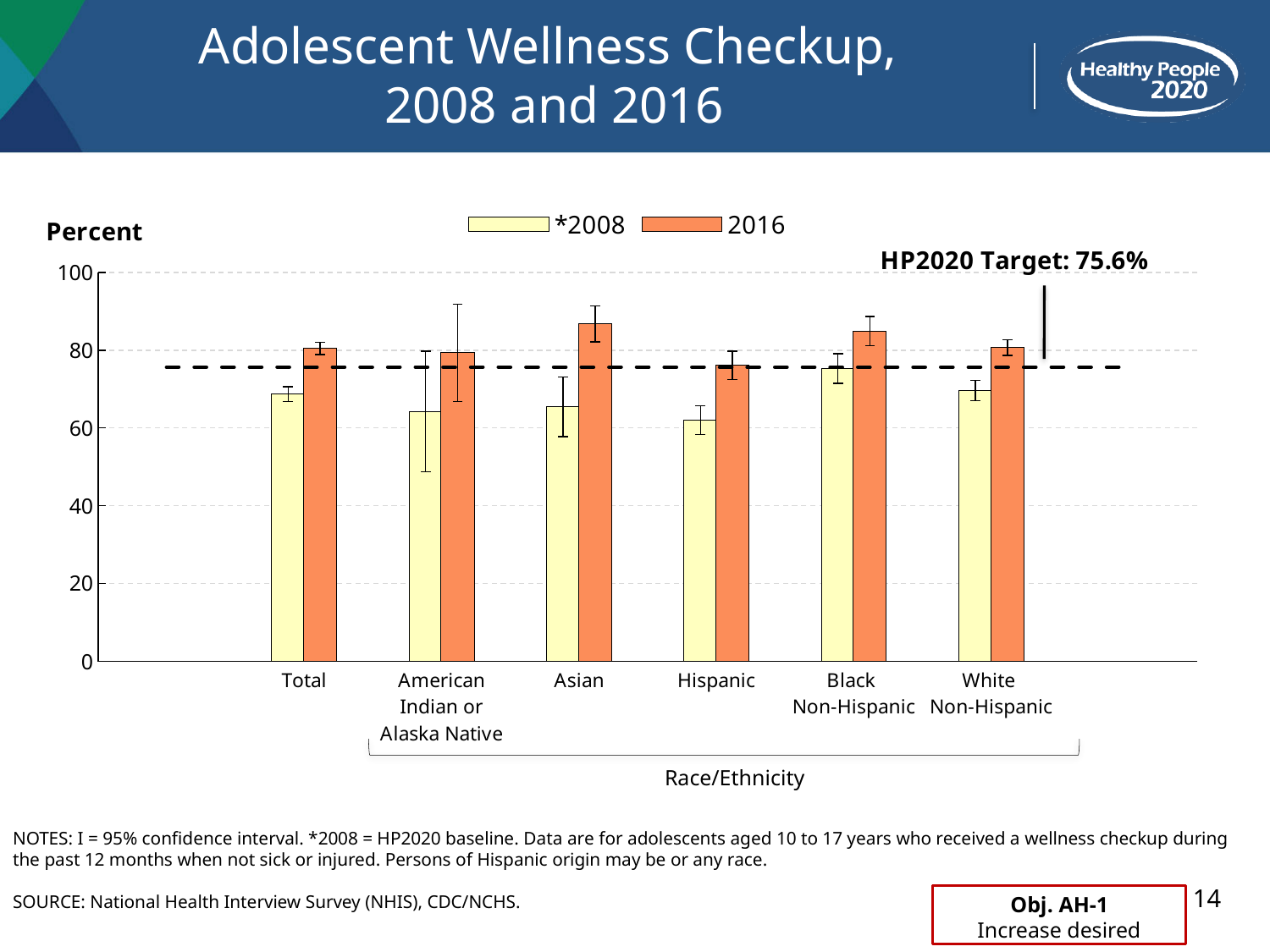
Is the 2008 value for Total greater or less than 60? greater For the 2008 series, which is larger: Black Non-Hispanic or Hispanic? Black Non-Hispanic Is the 2008 value for Hispanic greater or less than 80? less What is the HP2020 Target value shown on the chart? 75.6% Which category has the highest value for the 2008 series? Black Non-Hispanic What kind of chart is shown on the slide? bar chart Is the 2016 value for Asian greater or less than 80? greater How many categories are shown along the x axis? 6 Which category has the lowest value for the 2016 series? Hispanic For Asian, which is larger: the 2008 value or the 2016 value? 2016 How many series does the legend list? 2 What are the two series named in the legend? *2008 and 2016